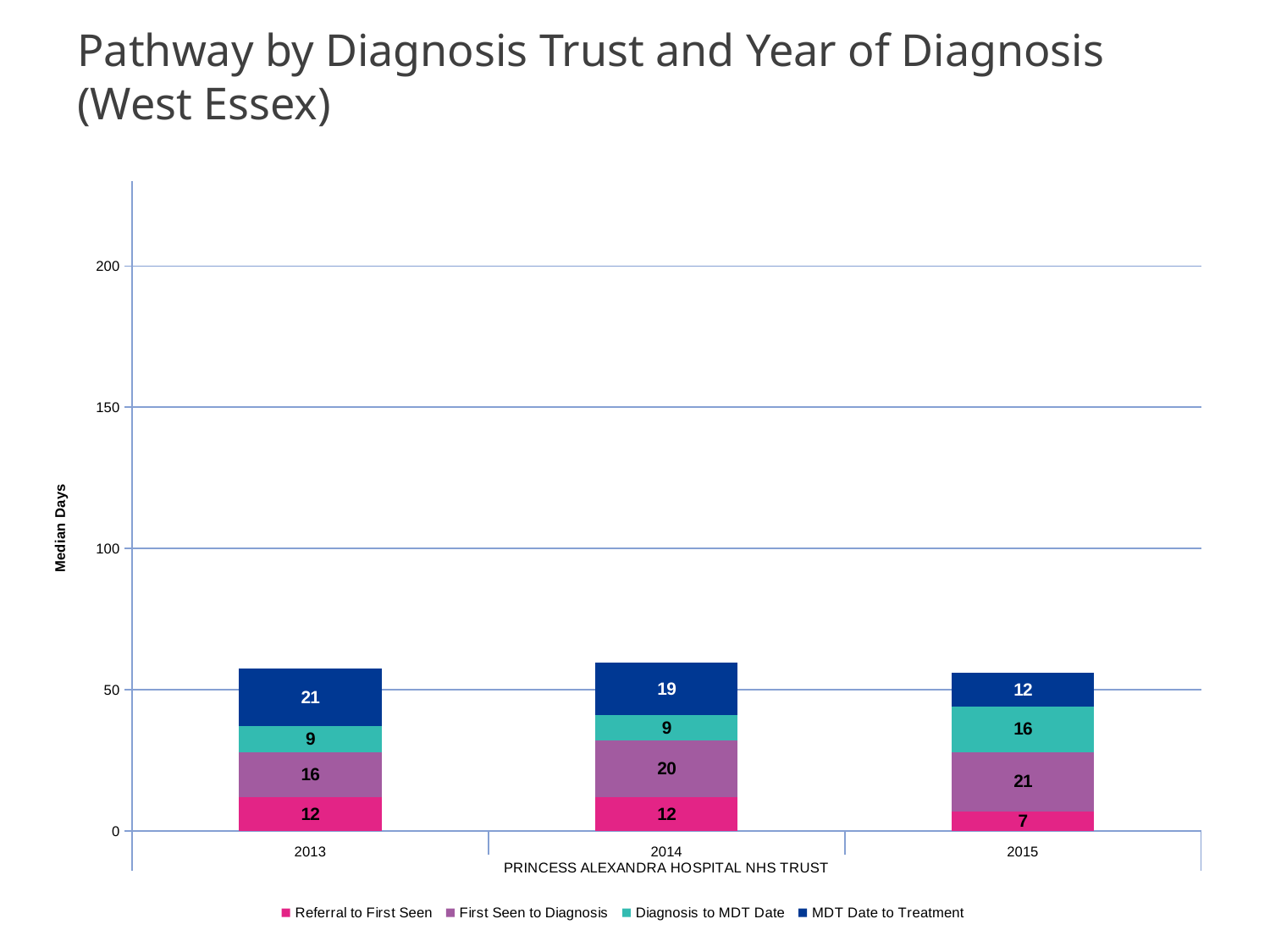
Which year has the lowest value for Referral to First Seen? 2015 What is the total of the stacked bar for 2014? 60 What is the value for Diagnosis to MDT Date in 2015? 16 What is the value for MDT Date to Treatment in 2015? 12 What is the value for First Seen to Diagnosis in 2014? 20 What kind of chart is shown on the slide? Stacked bar chart Which year has the highest value for MDT Date to Treatment? 2013 What is the value for Referral to First Seen in 2013? 12 How many series does the legend list? 4 What is the difference between the First Seen to Diagnosis values for 2015 and 2013? 5 How many years are shown on the x axis? 3 Is the Diagnosis to MDT Date value larger in 2015 or in 2014? 2015